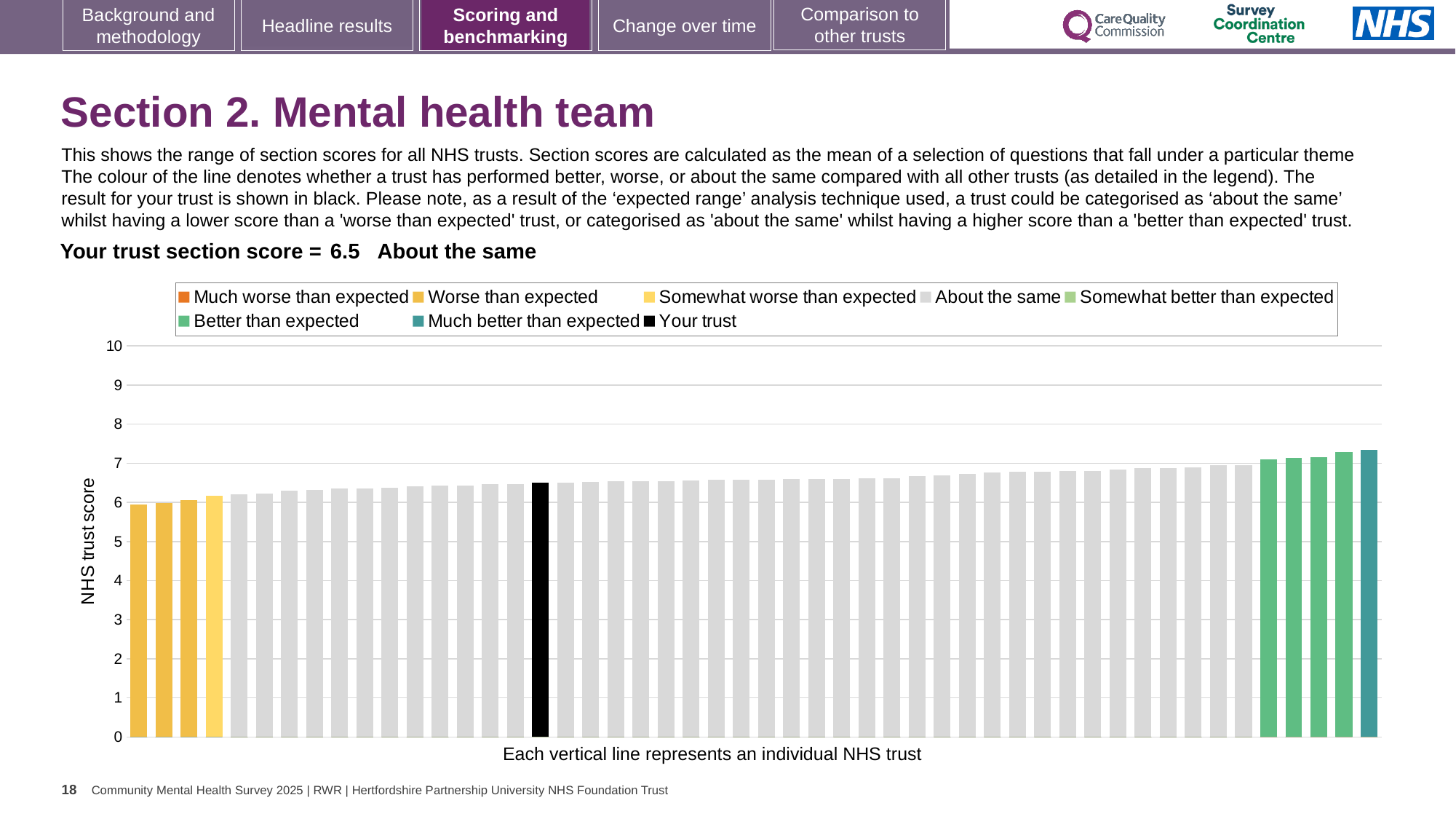
Do the bar values rise or fall from left to right along the x axis? rise What is the label on the vertical axis of the chart? NHS trust score How many bars are coloured in the 'Much better than expected' (teal) colour? 1 How many entries does the chart legend list? 8 What kind of chart is shown on the slide? bar chart Is the value of the tallest bar (rightmost) greater or less than 7? greater Is the value of the shortest bar (leftmost) greater or less than 7? less What colour is used for the 'Your trust' bar in the chart? black Which is higher: the black 'Your trust' bar or the rightmost bar? the rightmost bar What is the trust's section score for Section 2, Mental health team? 6.5 Which category is the trust's section score placed in, according to the slide? About the same Is the value of the black 'Your trust' bar greater or less than 6? greater